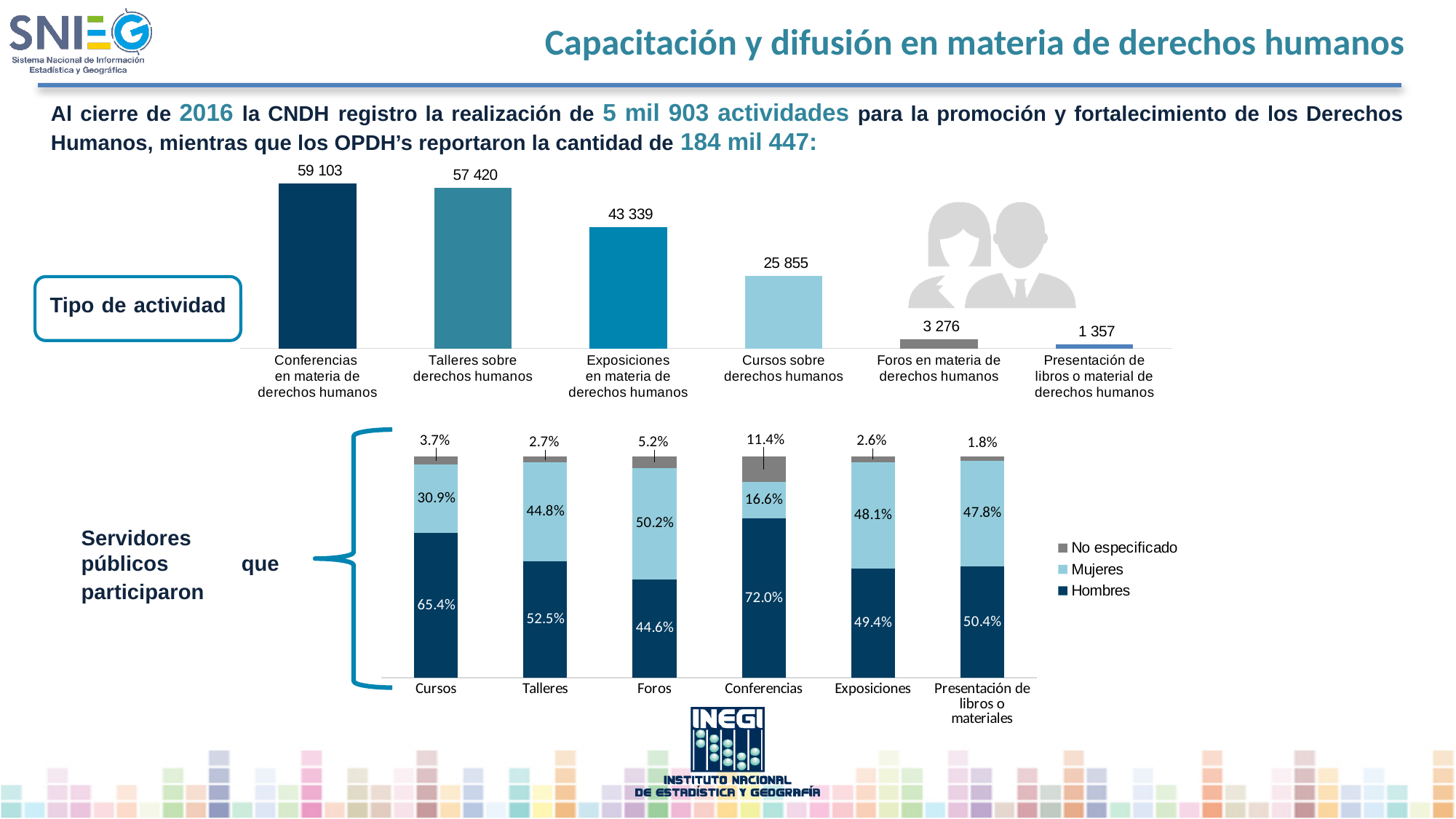
In the bottom 'Servidores públicos que participaron' chart, what percentage of participants in Foros were Mujeres? 50.2% In the top 'Tipo de actividad' chart, what is the value for Talleres sobre derechos humanos? 57 420 What kind of chart is the bottom 'Servidores públicos que participaron' chart? Stacked bar chart In the bottom 'Servidores públicos que participaron' chart, is the Hombres share larger for Cursos or for Talleres? Cursos In the top 'Tipo de actividad' chart, which activity type has the highest value? Conferencias en materia de derechos humanos In the bottom 'Servidores públicos que participaron' chart, how many series does the legend list? 3 In the bottom 'Servidores públicos que participaron' chart, what percentage of participants in Conferencias were Hombres? 72.0% In the top 'Tipo de actividad' chart, what is the difference between Conferencias en materia de derechos humanos and Talleres sobre derechos humanos? 1 683 In the bottom 'Servidores públicos que participaron' chart, which activity has the highest 'No especificado' share? Conferencias In the top 'Tipo de actividad' chart, what is the value for Foros en materia de derechos humanos? 3 276 In the top 'Tipo de actividad' chart, which activity type has the lowest value? Presentación de libros o material de derechos humanos In the top 'Tipo de actividad' chart, how many activity types are shown? 6